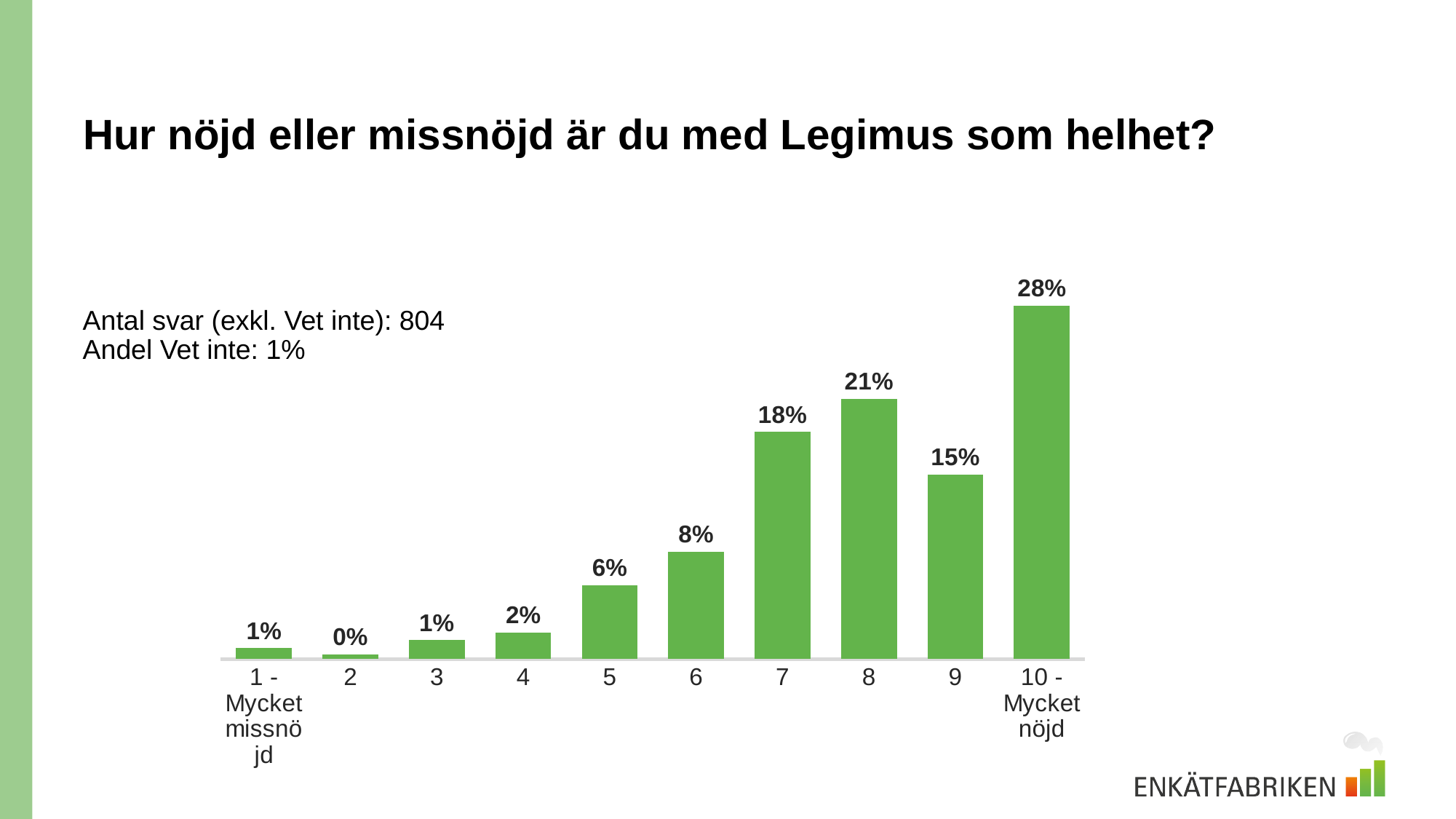
Which rating category has the lowest percentage? 2 What is the difference in percentage points between rating 8 and rating 9? 6 What kind of chart is shown on the slide? Bar chart Which has a higher percentage, rating 6 or rating 9? 9 How many rating categories are shown on the x axis? 10 What is the difference in percentage points between rating 10 and rating 7? 10 Which rating category has the highest percentage? 10 - Mycket nöjd What percentage of respondents gave a rating of 8? 21% What is the value shown for the rating "10 - Mycket nöjd"? 28% Do the values generally rise or fall from rating 1 to rating 8? Rise What is the number of responses (Antal svar, exkl. Vet inte) stated on the slide? 804 What percentage is shown for rating 5? 6%